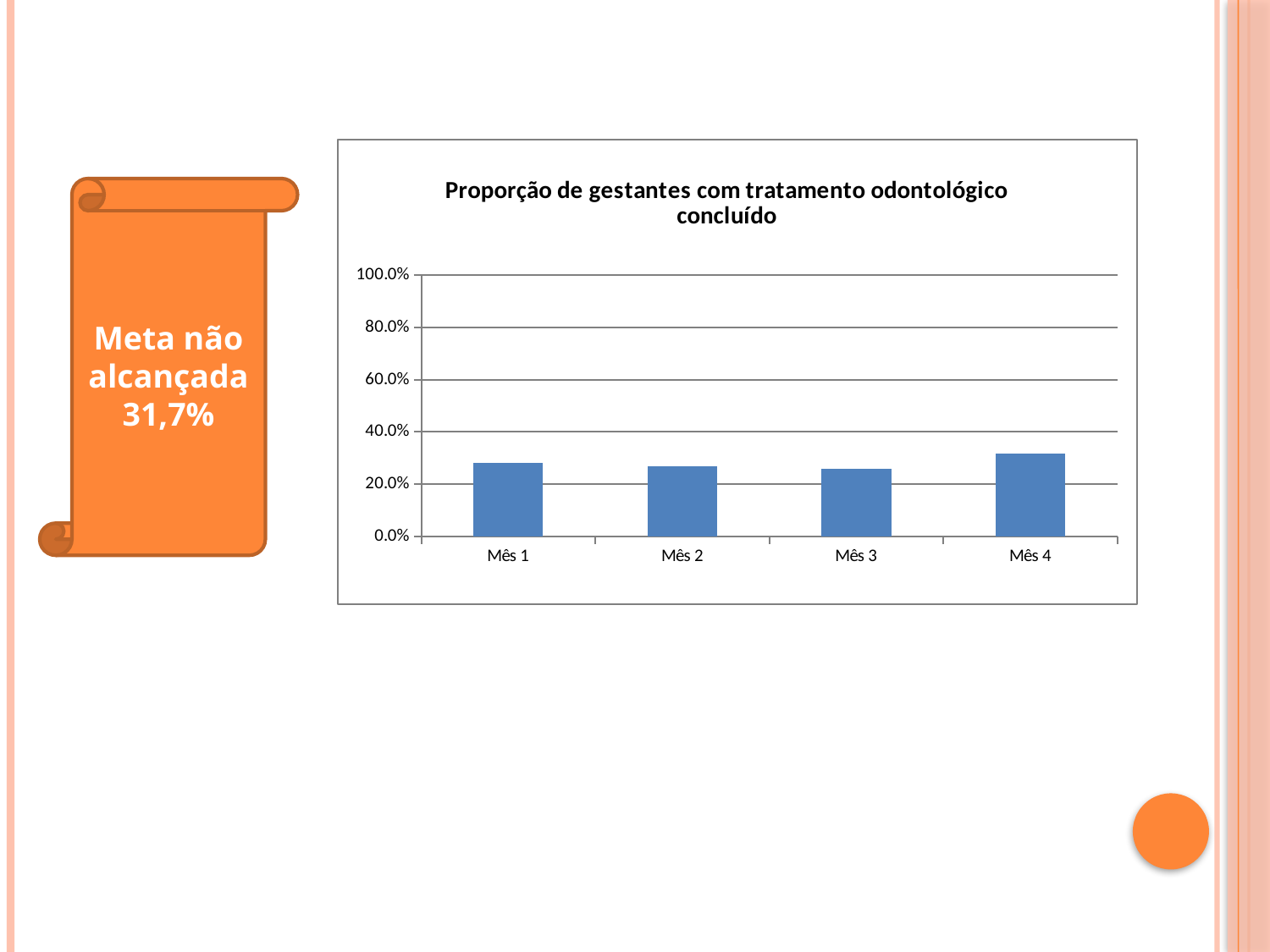
Which is larger, the value for Mês 4 or the value for Mês 3? Mês 4 What is the title of the chart? Proporção de gestantes com tratamento odontológico concluído Which month has the highest bar in the chart? Mês 4 Is the value for Mês 2 greater or less than 60.0%? less Is the value for Mês 3 greater or less than 40.0%? less What is the highest value shown on the y axis of the chart? 100.0% Is the value for Mês 4 greater or less than 40.0%? less What kind of chart is shown on the slide? bar chart Which is larger, the value for Mês 4 or the value for Mês 1? Mês 4 How many categories are plotted on the x axis of the chart? 4